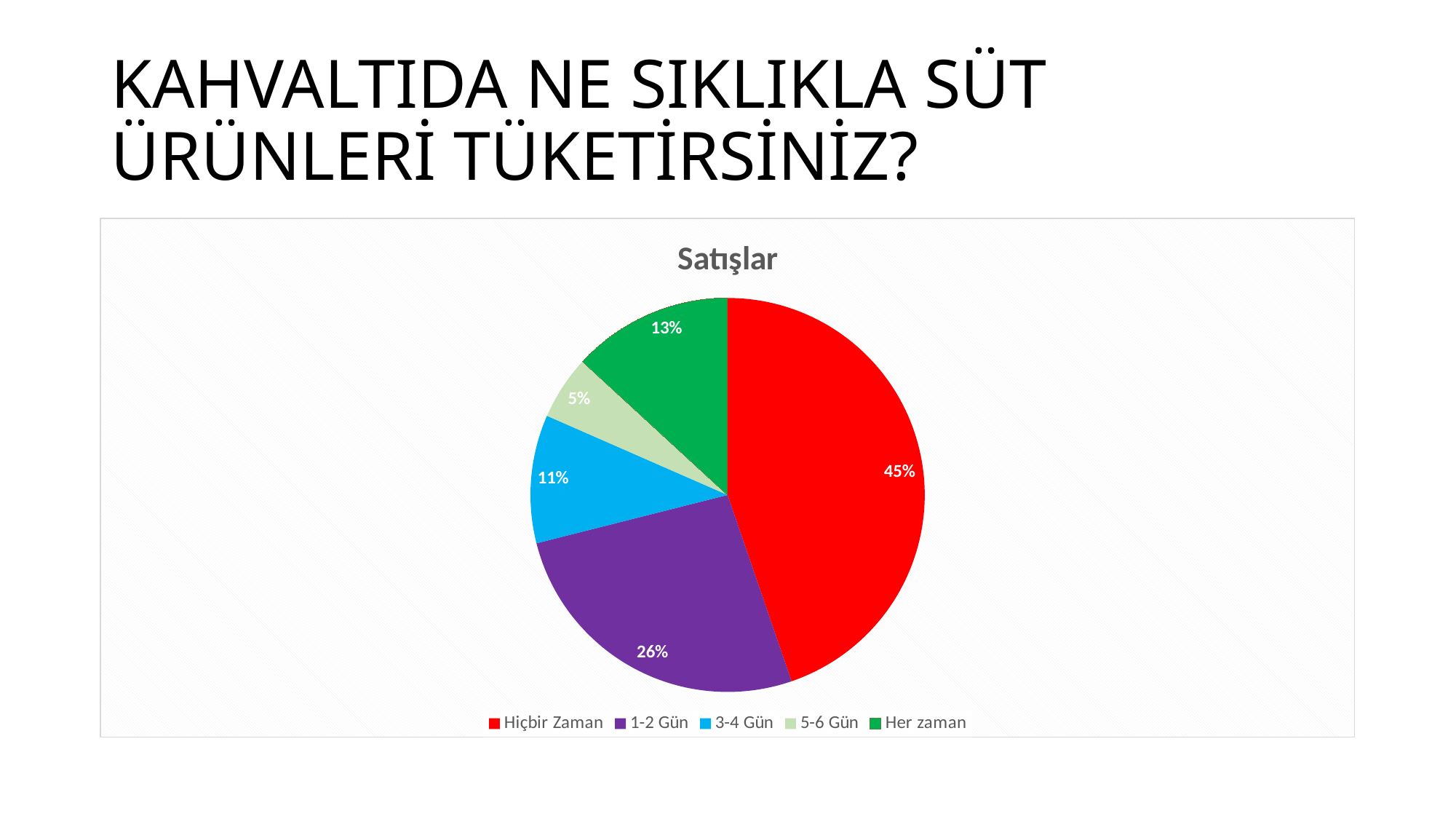
Which is larger, the Her zaman slice or the 3-4 Gün slice? Her zaman What is the value shown for the 1-2 Gün slice? 26% What is the title of the chart? Satışlar What is the value shown for the 3-4 Gün slice? 11% Which category has the smallest slice of the pie? 5-6 Gün What share of the pie does the Hiçbir Zaman slice represent? 45% What kind of chart is shown on the slide? Pie chart What is the value shown for the Her zaman slice? 13% Which category has the largest slice of the pie? Hiçbir Zaman What is the difference in percentage points between the Hiçbir Zaman and 1-2 Gün slices? 19 How many slices does the pie chart have? 5 What is the value shown for the 5-6 Gün slice? 5%